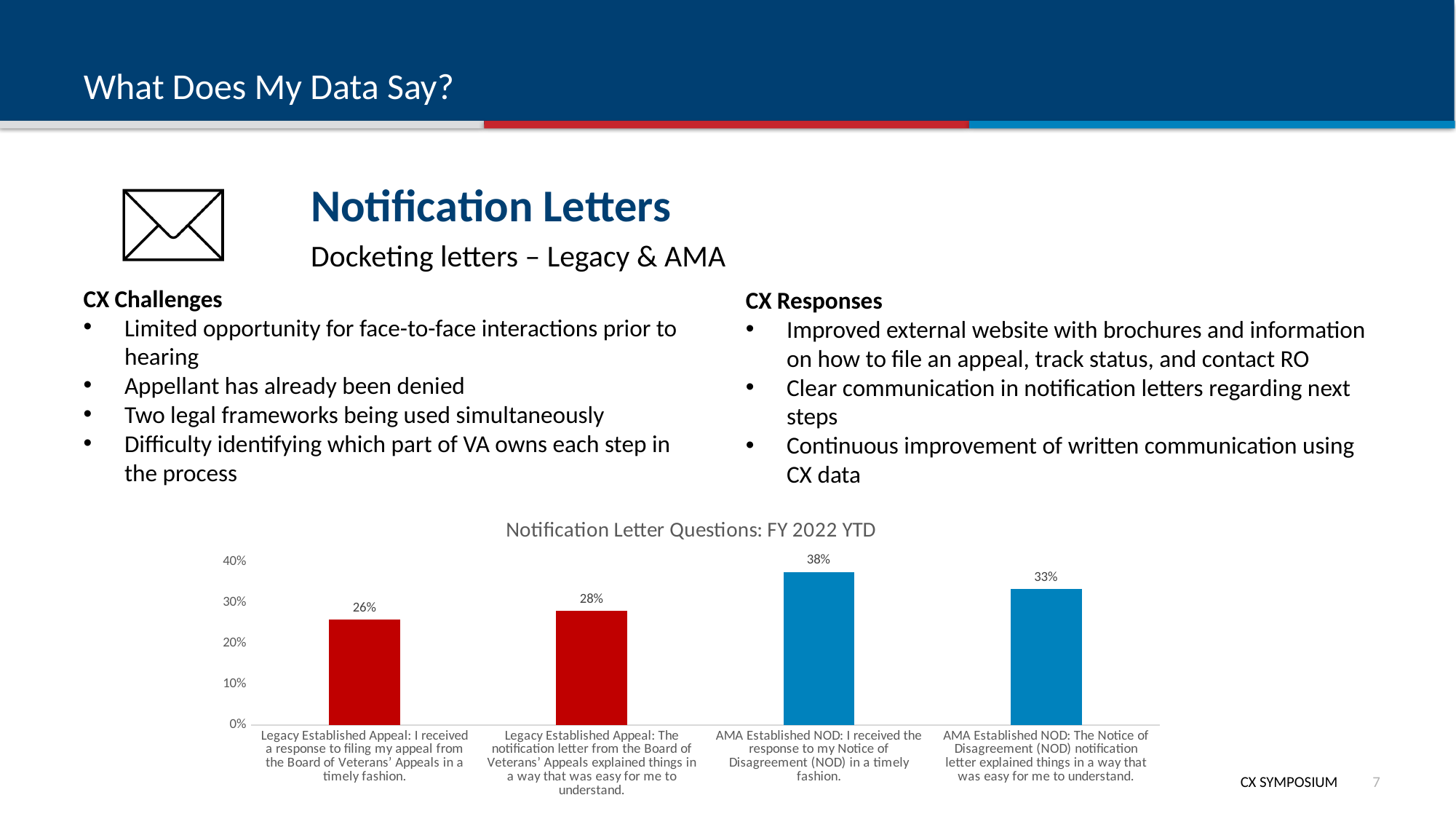
Which is larger: the value for "Legacy Established Appeal: The notification letter from the Board of Veterans' Appeals explained things in a way that was easy for me to understand" or the value for "AMA Established NOD: The Notice of Disagreement (NOD) notification letter explained things in a way that was easy for me to understand"? AMA Established NOD: The Notice of Disagreement (NOD) notification letter explained things in a way that was easy for me to understand. What is the value for "AMA Established NOD: The Notice of Disagreement (NOD) notification letter explained things in a way that was easy for me to understand"? 33% What is the title of the chart? Notification Letter Questions: FY 2022 YTD Which category has the lowest value? Legacy Established Appeal: I received a response to filing my appeal from the Board of Veterans' Appeals in a timely fashion. How many categories are shown on the chart? 4 What is the value for "AMA Established NOD: I received the response to my Notice of Disagreement (NOD) in a timely fashion"? 38% What kind of chart is shown on the slide? Bar chart What is the difference between the two AMA Established NOD values? 5% Which category has the highest value? AMA Established NOD: I received the response to my Notice of Disagreement (NOD) in a timely fashion. What is the value for "Legacy Established Appeal: I received a response to filing my appeal from the Board of Veterans' Appeals in a timely fashion"? 26% What is the difference between the highest and lowest values on the chart? 12% Is the value for "Legacy Established Appeal: The notification letter from the Board of Veterans' Appeals explained things in a way that was easy for me to understand" greater or less than 30%? less